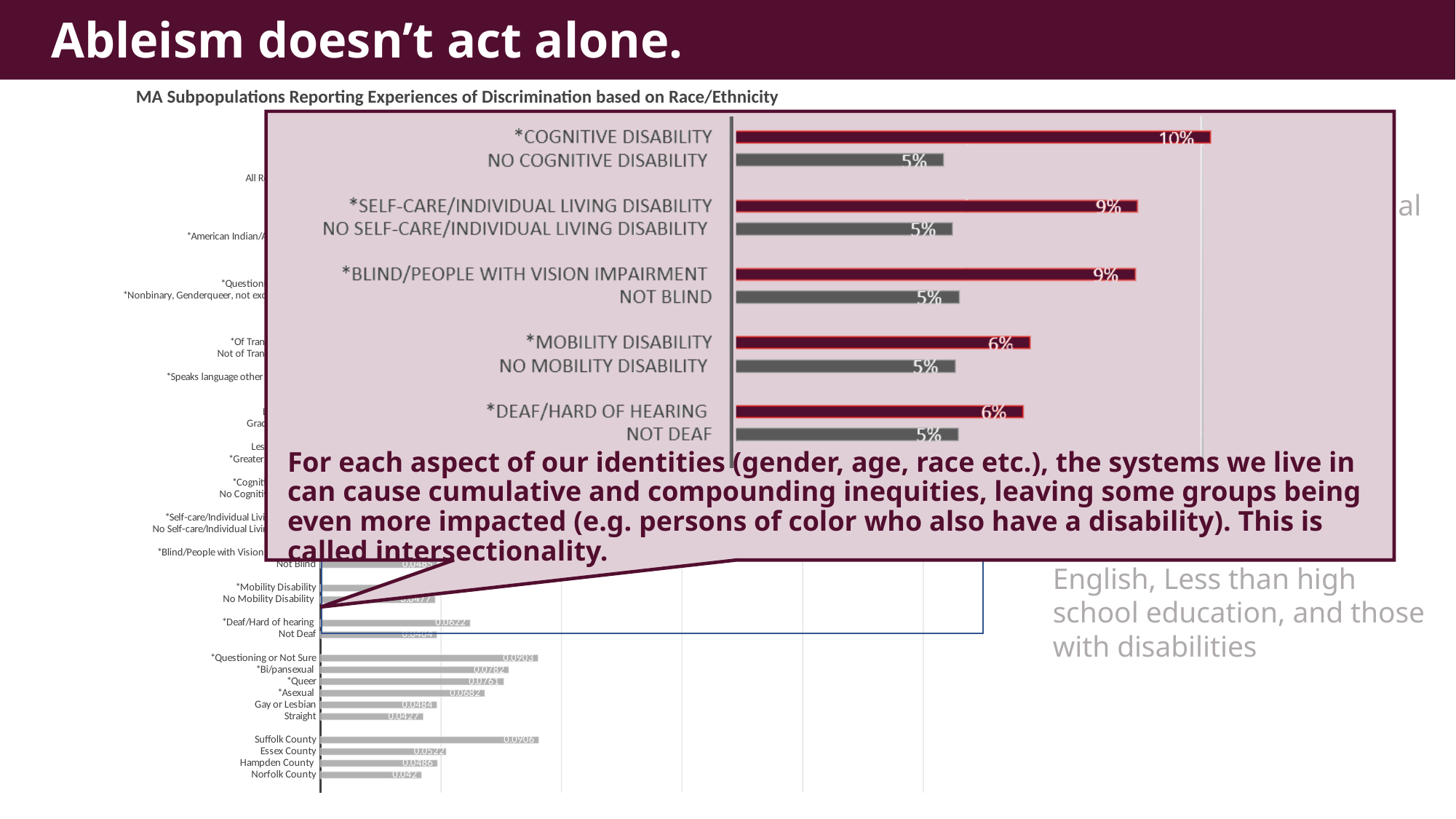
How many bars are shown in the inset chart? 10 In the inset chart, what percentage is shown for Mobility Disability? 6% In the inset chart, which is larger: Cognitive Disability or Deaf/Hard of Hearing? Cognitive Disability In the inset chart, what is the difference between Self-Care/Individual Living Disability and No Self-Care/Individual Living Disability? 4% What type of chart is the inset chart? Bar chart In the inset chart, which is larger: Deaf/Hard of Hearing or Mobility Disability? They are equal (6%) In the inset chart, what percentage is shown for Cognitive Disability? 10% In the background chart, what value is shown for Suffolk County? 0.0906 In the inset chart, which category has the highest value? Cognitive Disability In the inset chart, what percentage is shown for Blind/People with Vision Impairment? 9% In the inset chart, what is the difference between Cognitive Disability and No Cognitive Disability? 5% What is the title of the background chart? MA Subpopulations Reporting Experiences of Discrimination based on Race/Ethnicity